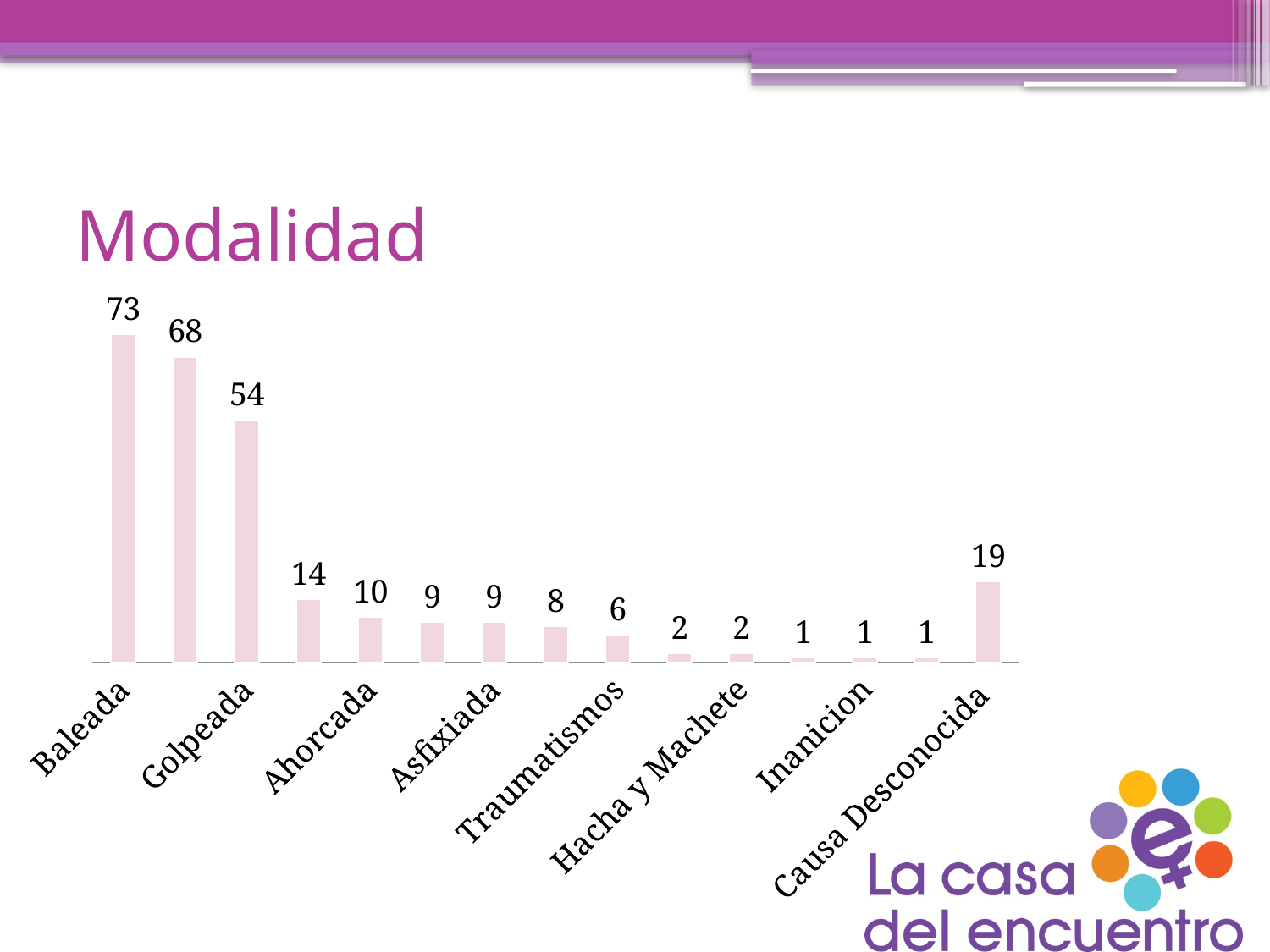
What is the value for Ahorcada? 10 What is the value for Baleada? 73 What kind of chart is shown on the slide? Bar chart What is the title of the slide? Modalidad Which is larger, the value for Causa Desconocida or the value for Ahorcada? Causa Desconocida What is the value for Traumatismos? 6 What is the value for Causa Desconocida? 19 What is the value for Inanicion? 1 What is the value for Golpeada? 54 How many bars are plotted in the chart? 15 Which category has the highest value? Baleada What is the difference between the values for Baleada and Golpeada? 19